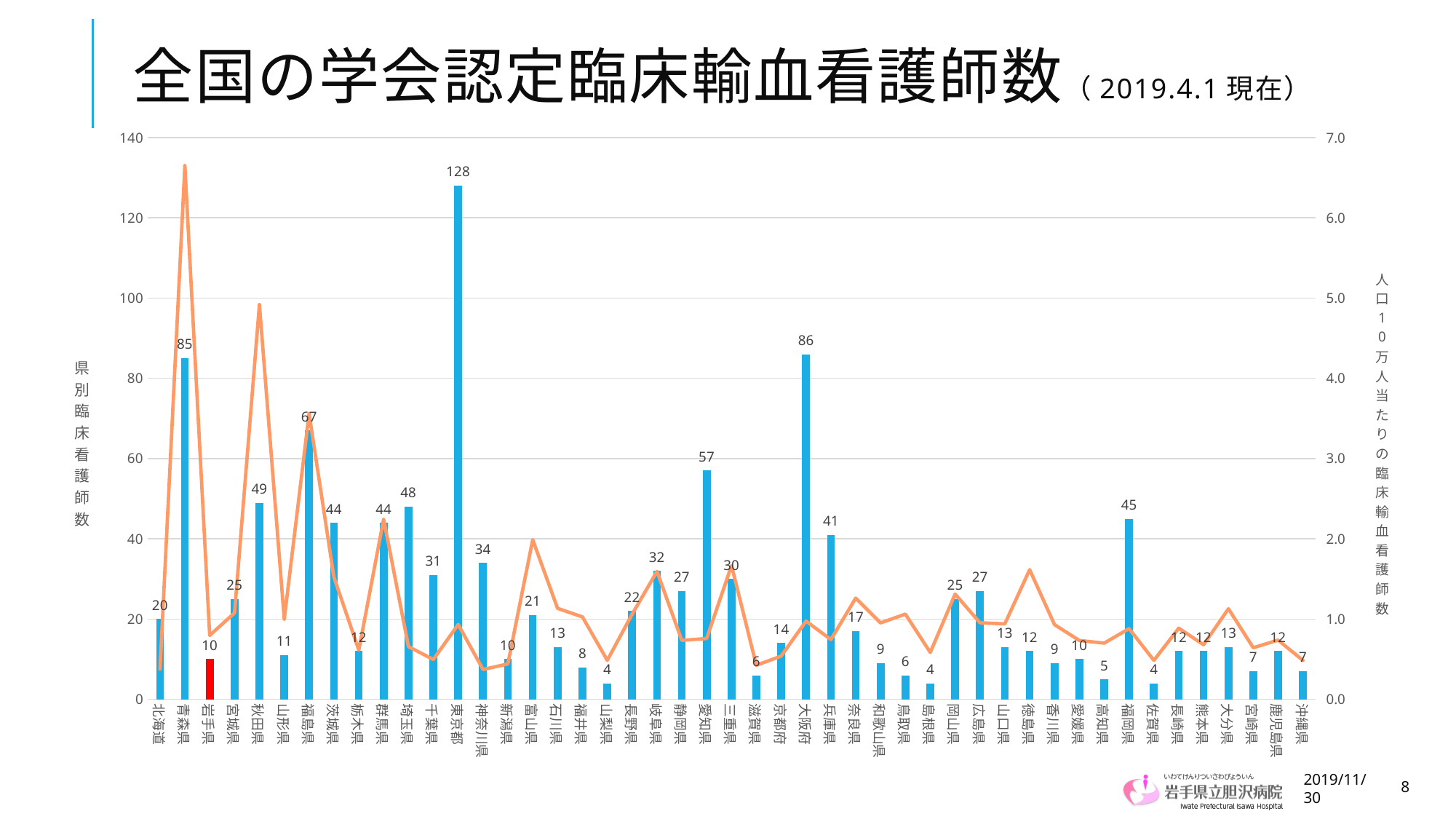
How many prefectures are shown on the x axis? 47 What is the value shown for 岩手県, the red bar? 10 Which prefecture has the highest bar value? 東京都 What is the difference between the values for 青森県 and 岩手県? 75 Which prefecture's bar is highlighted in red? 岩手県 What is the value shown for 大阪府? 86 Which has a larger bar value, 愛知県 or 福岡県? 愛知県 What is the number of certified clinical transfusion nurses for 東京都? 128 What is the difference between the values for 東京都 and 大阪府? 42 On the orange line (right axis), is the value for 青森県 greater or less than 6.0? greater What is the value shown for 福岡県? 45